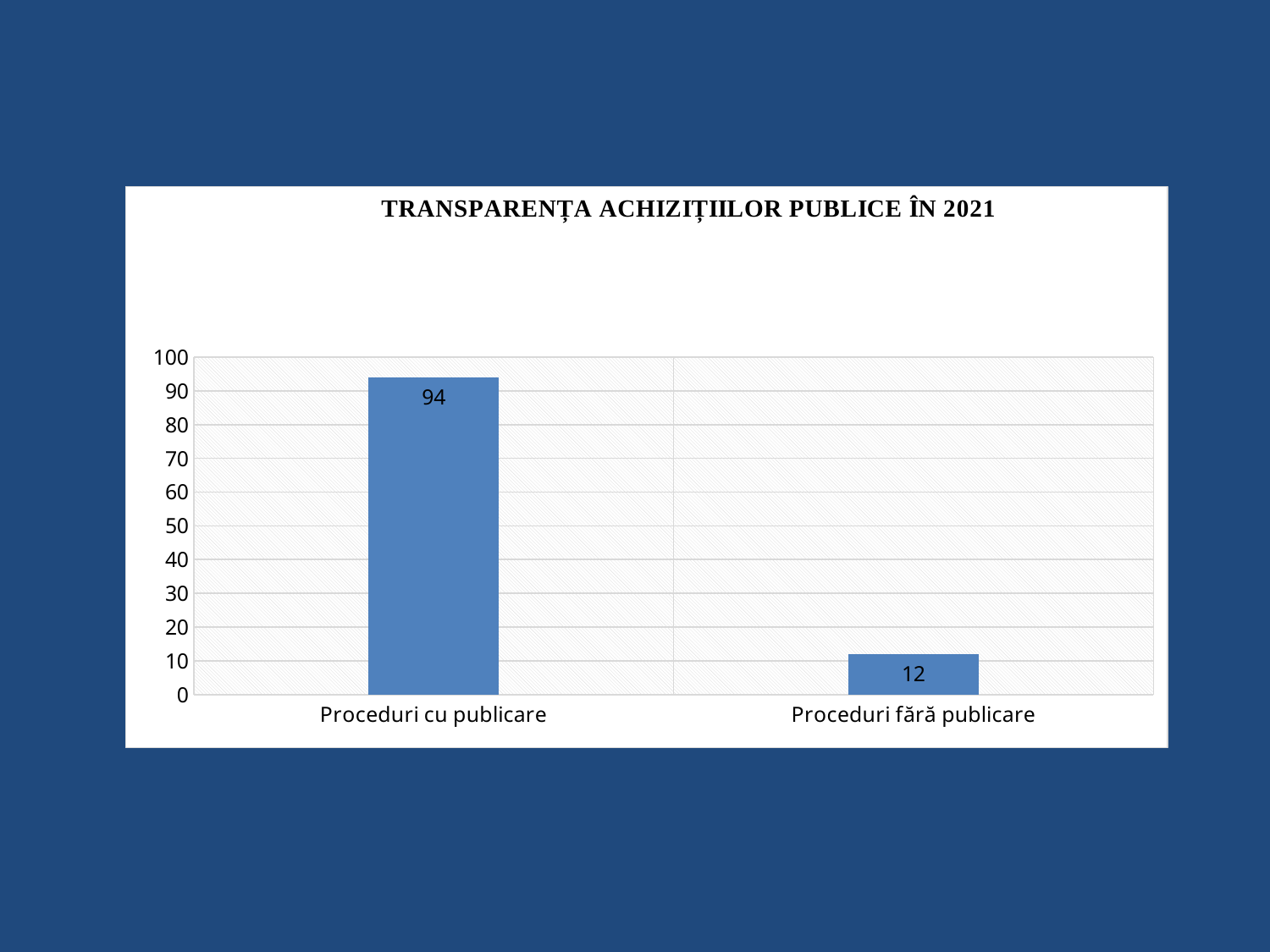
What kind of chart is shown on the slide? bar chart What is the value for Proceduri cu publicare? 94 Which is larger, the value for Proceduri cu publicare or the value for Proceduri fără publicare? Proceduri cu publicare Is the value for Proceduri cu publicare greater or less than 90? greater How many categories are shown on the x axis? 2 Is the value for Proceduri fără publicare greater or less than 20? less Which category has the lowest value? Proceduri fără publicare What is the maximum value shown on the vertical axis? 100 What is the title of the chart? TRANSPARENȚA ACHIZIȚIILOR PUBLICE ÎN 2021 Which category has the highest value? Proceduri cu publicare What is the value for Proceduri fără publicare? 12 What is the difference between the values for Proceduri cu publicare and Proceduri fără publicare? 82